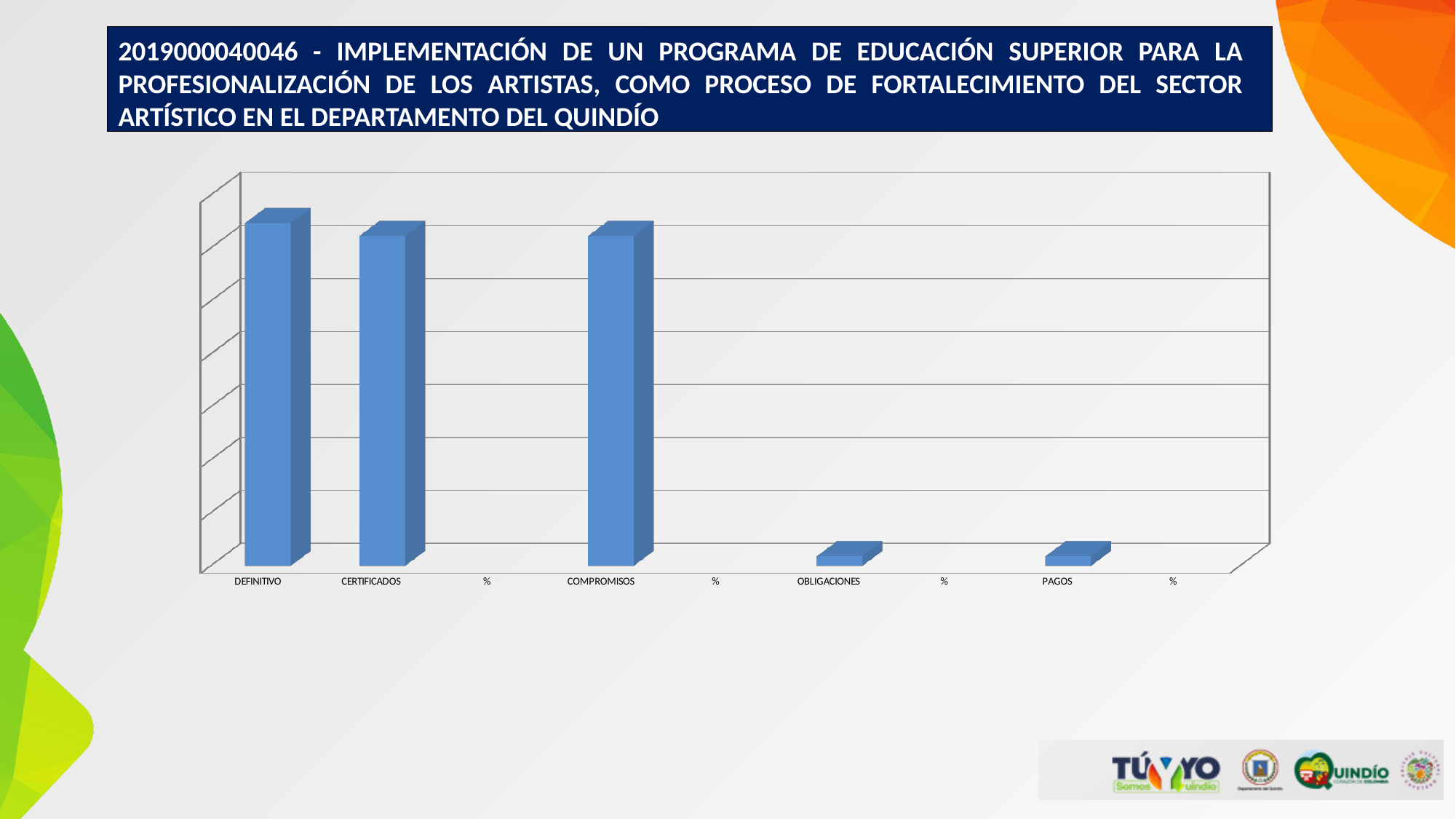
How many category labels are shown along the x axis of the chart? 9 What is the first category label on the x axis of the chart? DEFINITIVO What colour are the bars in the chart? blue Which is larger, the bar for COMPROMISOS or the bar for PAGOS? COMPROMISOS Which is larger, the bar for CERTIFICADOS or the bar for OBLIGACIONES? CERTIFICADOS What kind of chart is shown on the slide? bar chart Which is larger, the bar for DEFINITIVO or the bar for OBLIGACIONES? DEFINITIVO Which category has the tallest bar in the chart? DEFINITIVO